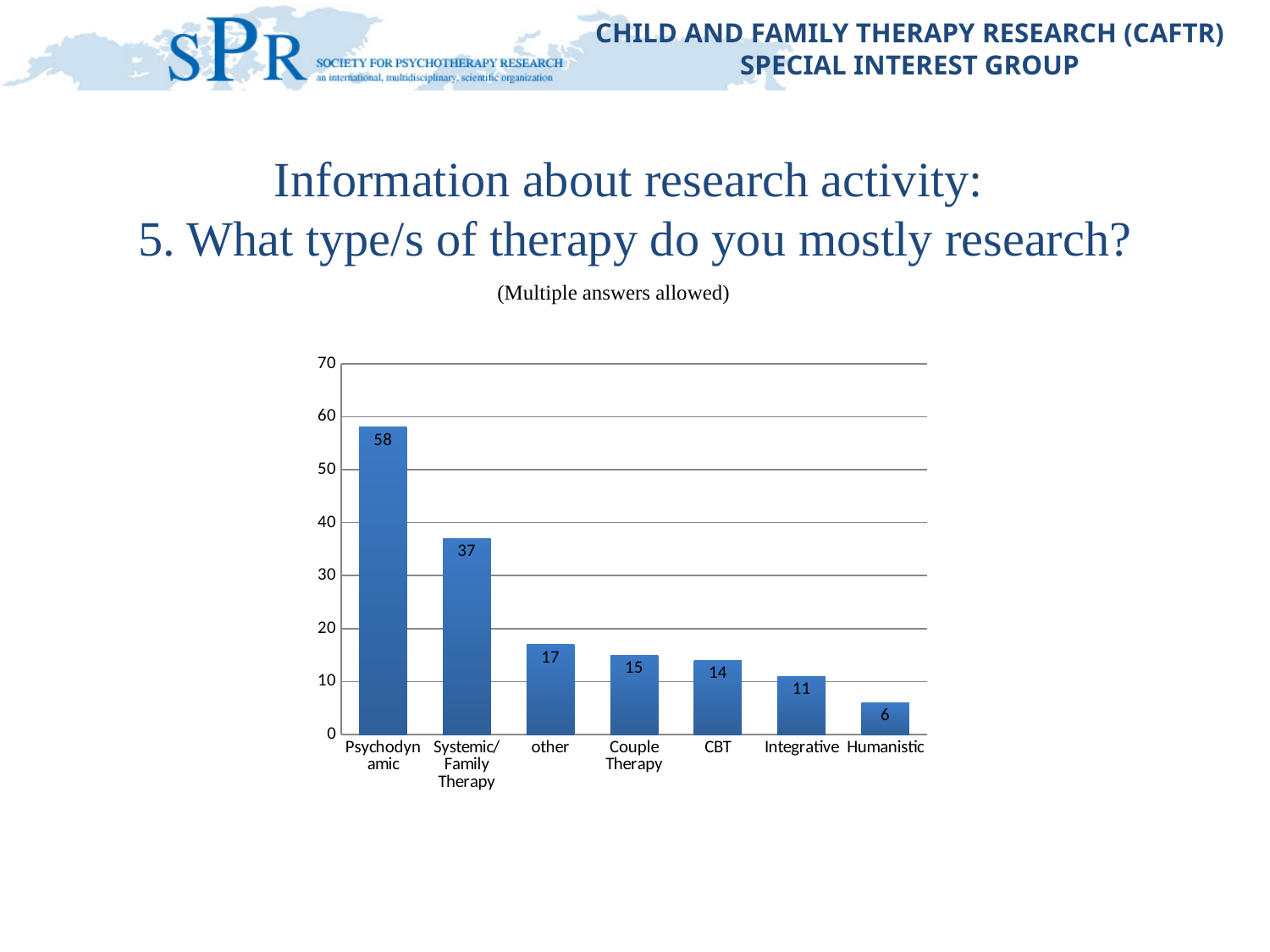
What is the difference between the values for Couple Therapy and Integrative? 4 What is the value for Psychodynamic? 58 Which is larger, the value for other or the value for CBT? other What is the value for Systemic/Family Therapy? 37 What is the value for CBT? 14 What is the value for Humanistic? 6 How many therapy categories are shown on the x axis? 7 Do the values rise or fall from left to right along the x axis? Fall Which therapy type has the lowest value? Humanistic What is the difference between the values for Psychodynamic and Systemic/Family Therapy? 21 Which therapy type has the highest value? Psychodynamic What kind of chart is shown on the slide? Bar chart